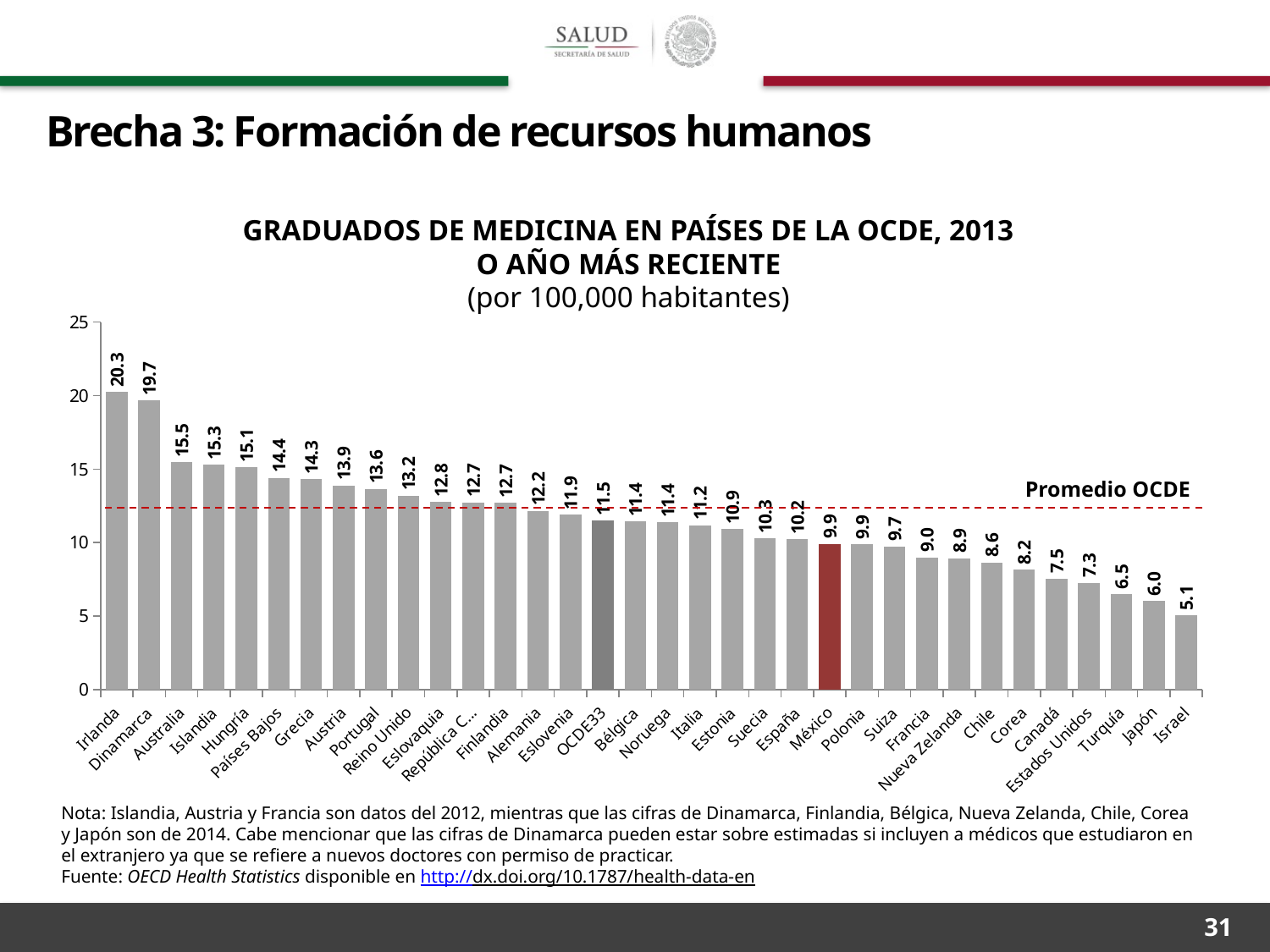
What is the value for OCDE33? 11.5 What kind of chart is shown on the slide? Bar chart How many bars are plotted in the chart? 34 What is the value for Canadá? 7.5 Is the value for Dinamarca greater or less than 15? greater Which has a larger value, Turquía or Japón? Turquía What is the difference between the values for Irlanda and Israel? 15.2 Which country has the highest value? Irlanda Which country has the lowest value? Israel What is the value for México? 9.9 What is the difference between the values for OCDE33 and México? 1.6 Do the values rise or fall from left to right along the x axis? Fall